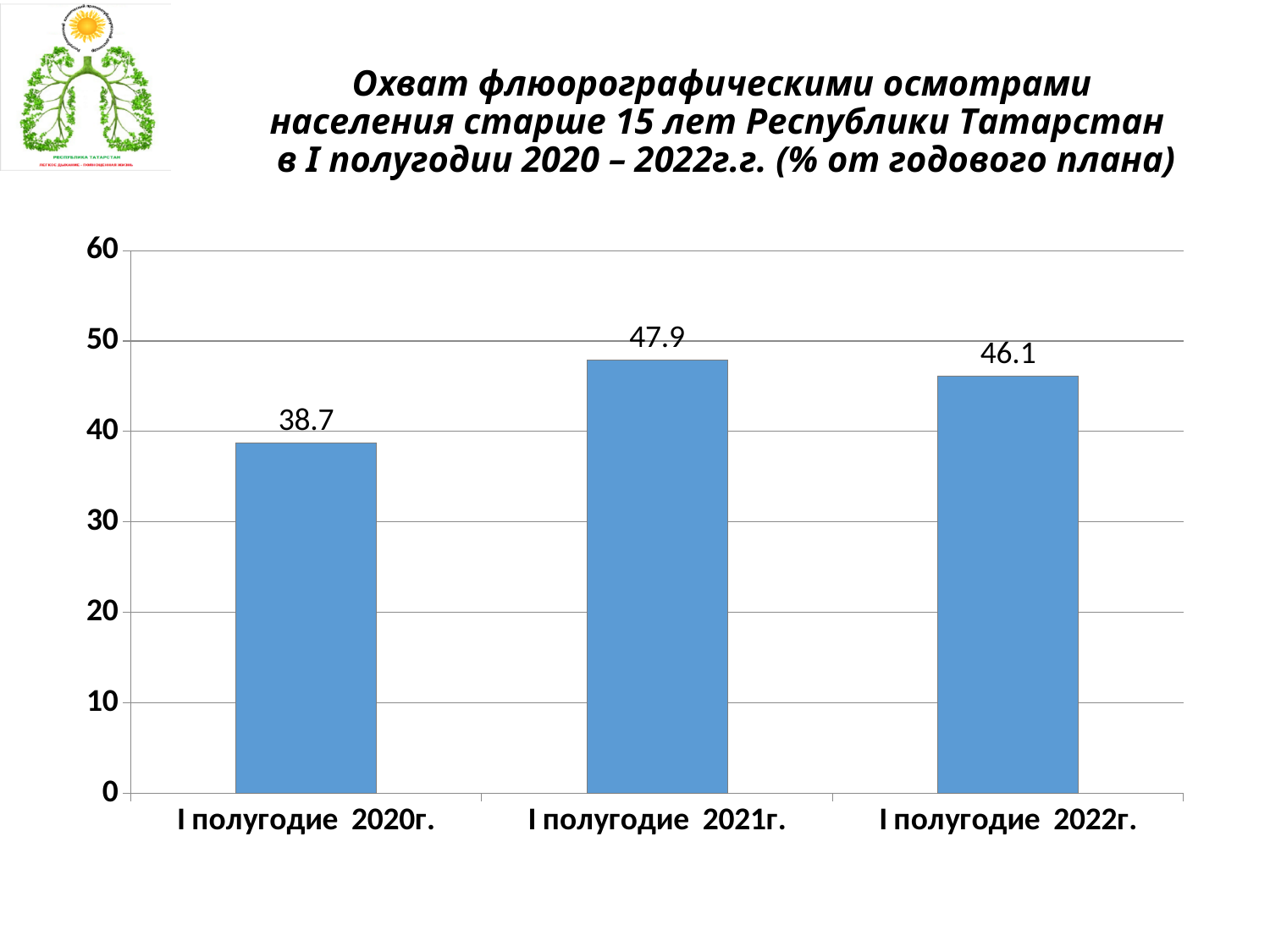
How many categories are shown on the x axis? 3 What is the value for I полугодие 2021г.? 47.9 What is the difference between the values for I полугодие 2021г. and I полугодие 2022г.? 1.8 What is the value for I полугодие 2020г.? 38.7 What is the highest value shown on the y axis? 60 What is the value for I полугодие 2022г.? 46.1 Which is larger, the value for I полугодие 2022г. or I полугодие 2020г.? I полугодие 2022г. What kind of chart is shown on the slide? bar chart Which category has the lowest value? I полугодие 2020г. Is the value for I полугодие 2020г. greater or less than 40? less What is the difference between the values for I полугодие 2021г. and I полугодие 2020г.? 9.2 Which category has the highest value? I полугодие 2021г.